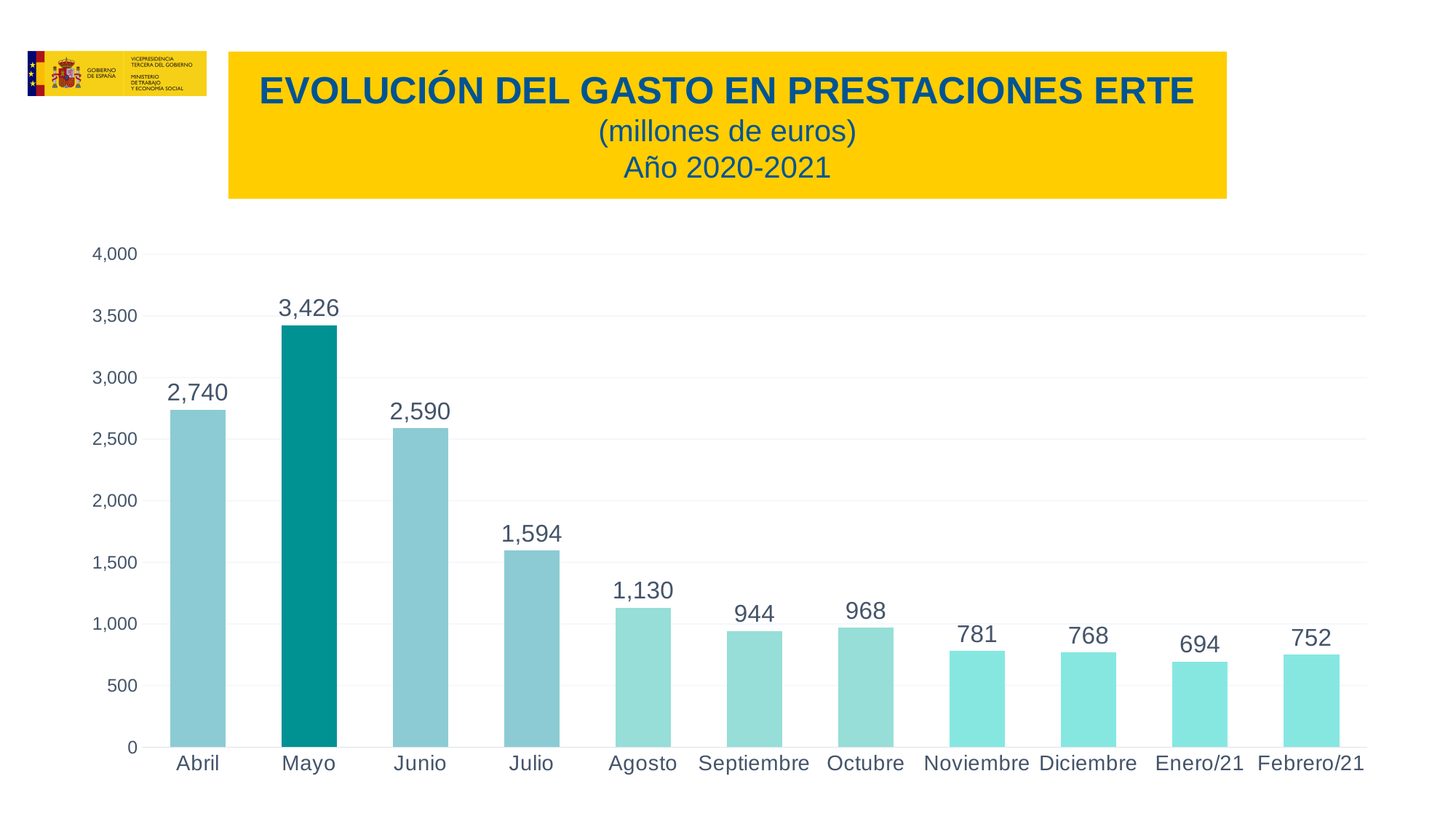
What is the value for Agosto? 1,130 Is the value for Julio greater or less than 1,500? greater What kind of chart is shown on the slide? Bar chart Which month has the lowest value? Enero/21 What unit is stated in the chart title? millones de euros What is the difference between the values for Abril and Junio? 150 Which is larger, the value for Septiembre or the value for Octubre? Octubre Do the values generally rise or fall from Mayo to Enero/21? Fall What is the value for Mayo? 3,426 What is the value for Enero/21? 694 Which month has the highest value? Mayo How many months are shown on the x axis? 11